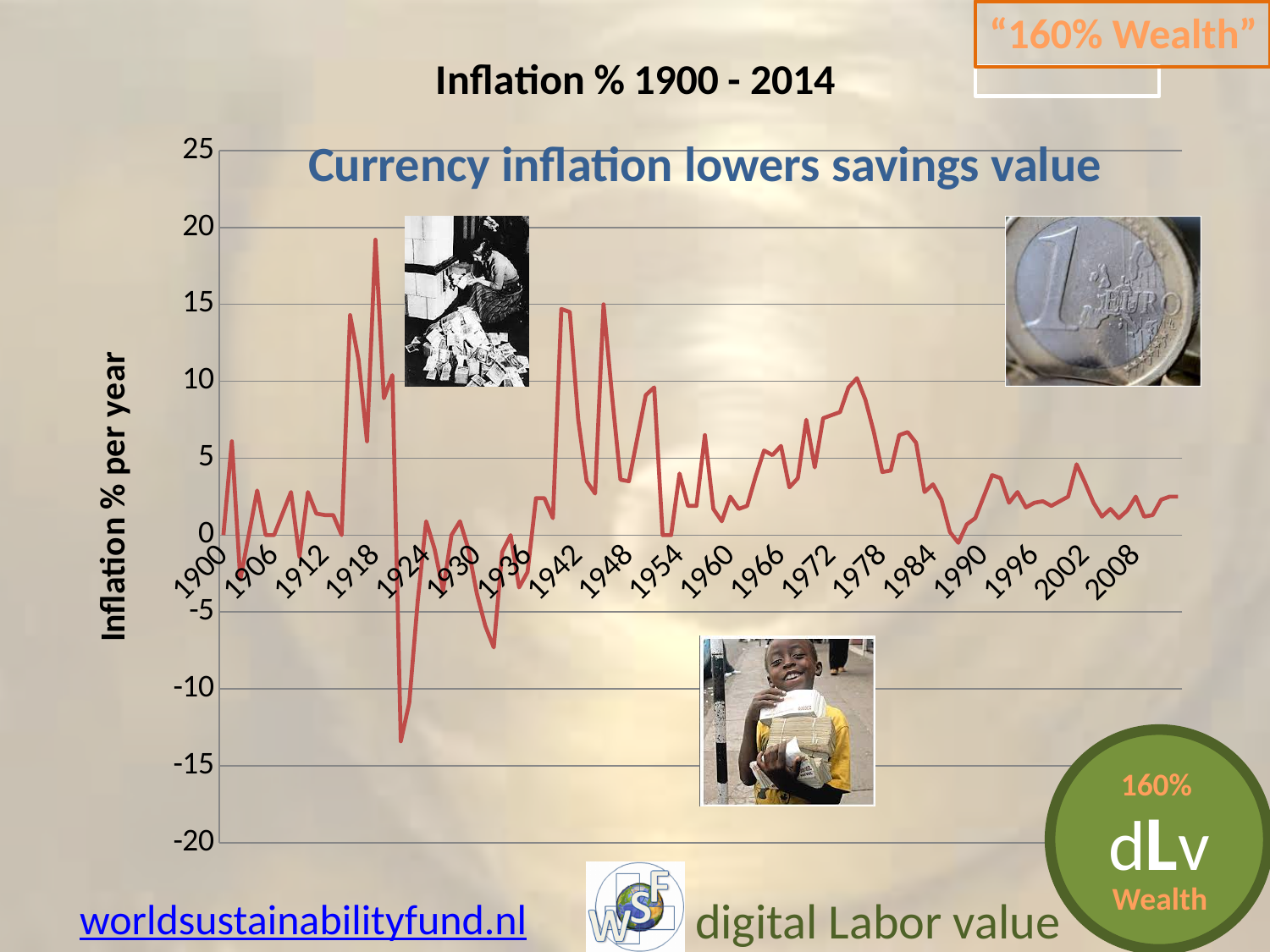
What is the title of the chart? Inflation % 1900 - 2014 Is the highest peak of the inflation line, around 1920, greater or less than 15? greater Is the inflation value for 1900 greater or less than 5? less How many year labels are shown on the horizontal axis? 19 What is the label on the vertical axis of the chart? Inflation % per year Is the inflation value at the peak around 1942 greater or less than 10? greater What is the lowest value shown on the vertical axis? -20 Does the inflation line generally rise or fall between 1978 and 1990? fall Which is larger: the inflation peak around 1920 or the inflation peak around 1975? the peak around 1920 What kind of chart is shown on the slide? line chart